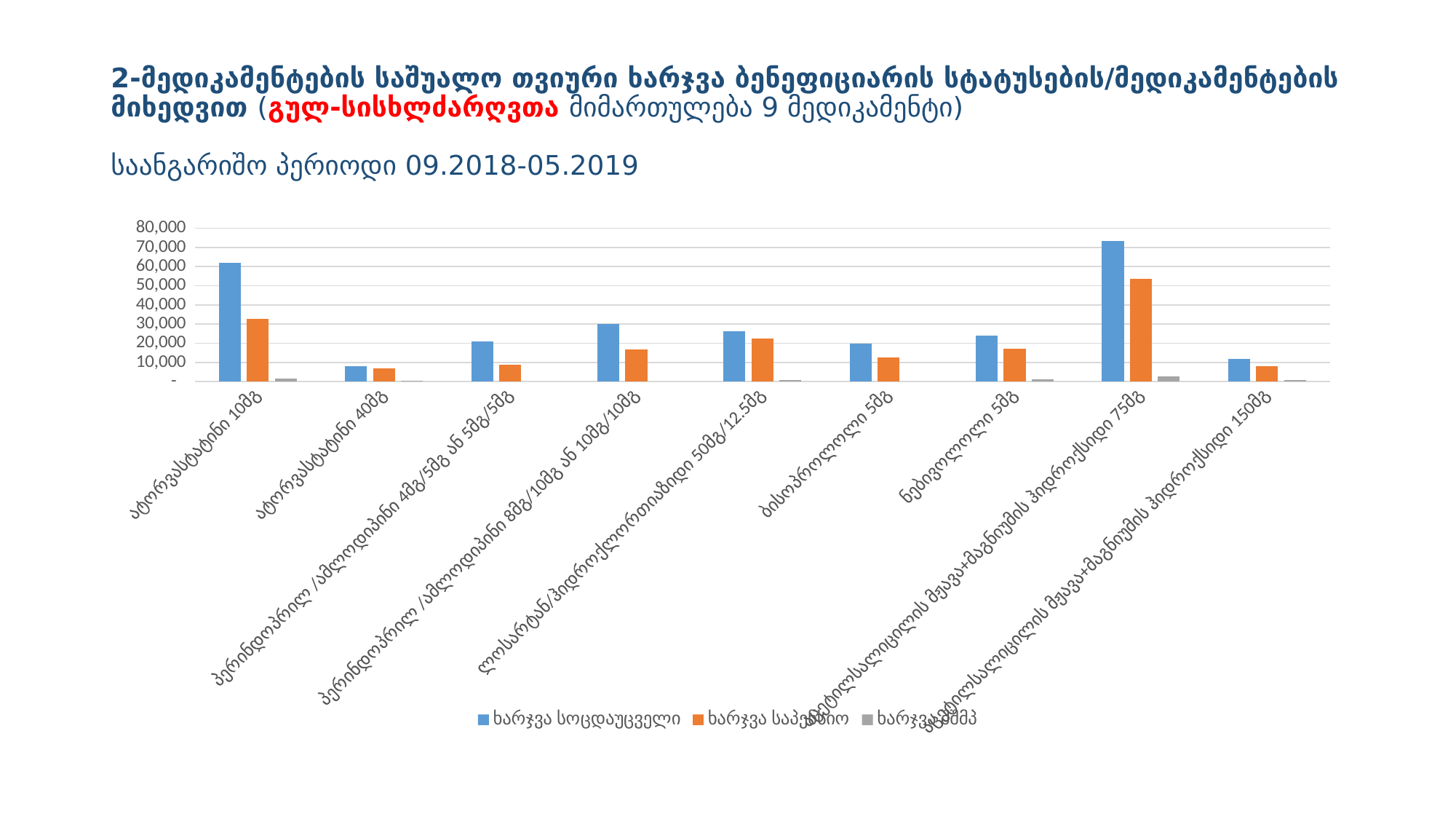
What kind of chart is shown on the slide? bar chart How many medication categories are shown on the x axis of the chart? 9 Is the ხარჯვა საპენსიო value for ბისოპროლოლი 5მგ greater or less than 20,000? less What reporting period is stated on the slide above the chart? 09.2018-05.2019 How many series does the chart legend list? 3 What colour are the bars for the ხარჯვა საპენსიო series? orange Is the ხარჯვა საპენსიო value for აცეტილსალიცილის მჟავა+მაგნიუმის ჰიდროქსიდი 75მგ greater or less than 40,000? greater